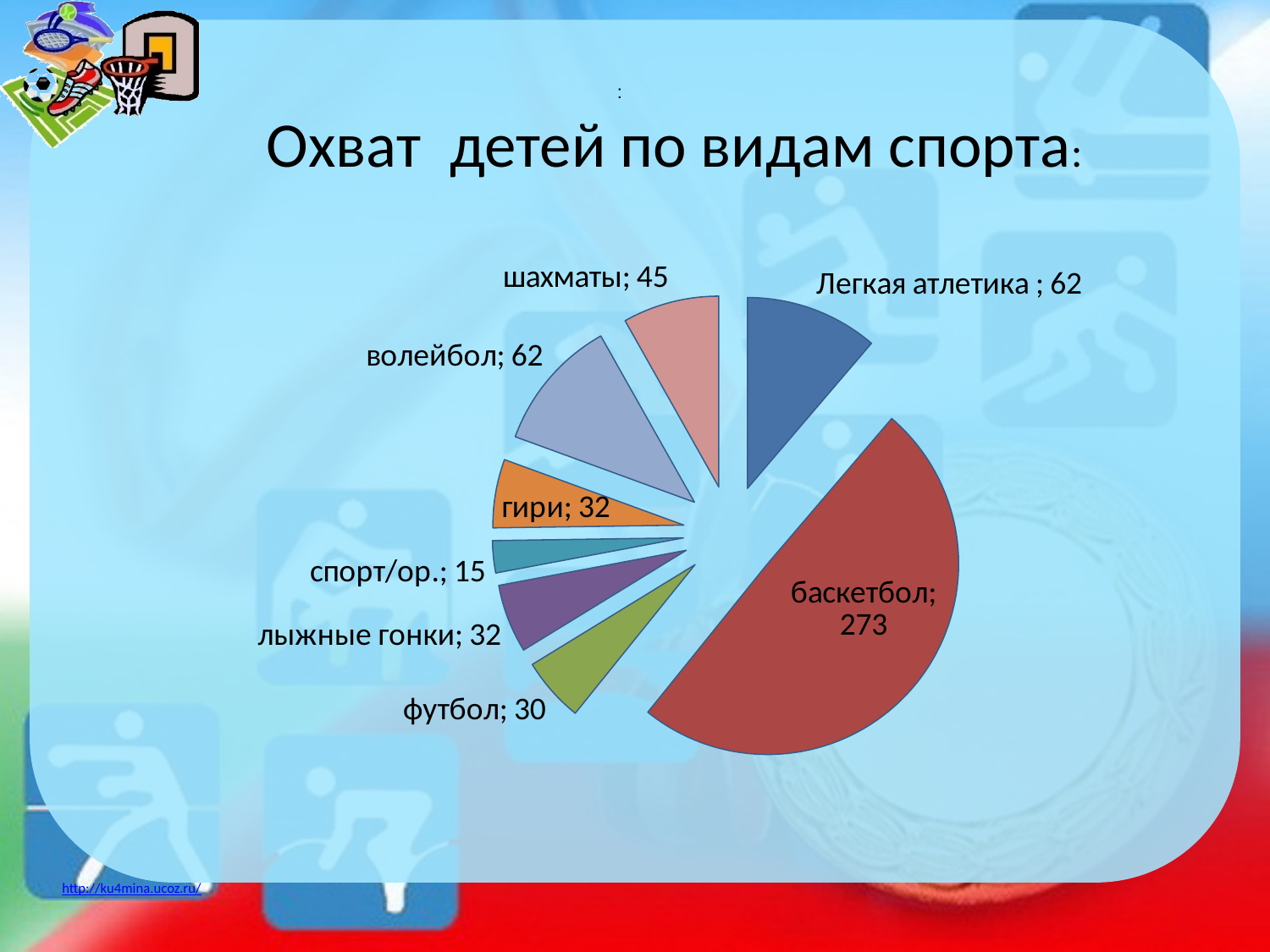
What is the chart's title? Охват детей по видам спорта What is the value for баскетбол? 273 What kind of chart is shown on the slide? pie chart What is the value for спорт/ор.? 15 Which is larger, the value for шахматы or the value for футбол? шахматы How many slices (sports) does the pie chart have? 8 Which sport has the largest slice? баскетбол What is the total of all the values shown in the pie chart? 551 What is the value for шахматы? 45 What is the value for волейбол? 62 Which sport has the smallest slice? спорт/ор. What is the difference between the values for баскетбол and Легкая атлетика? 211